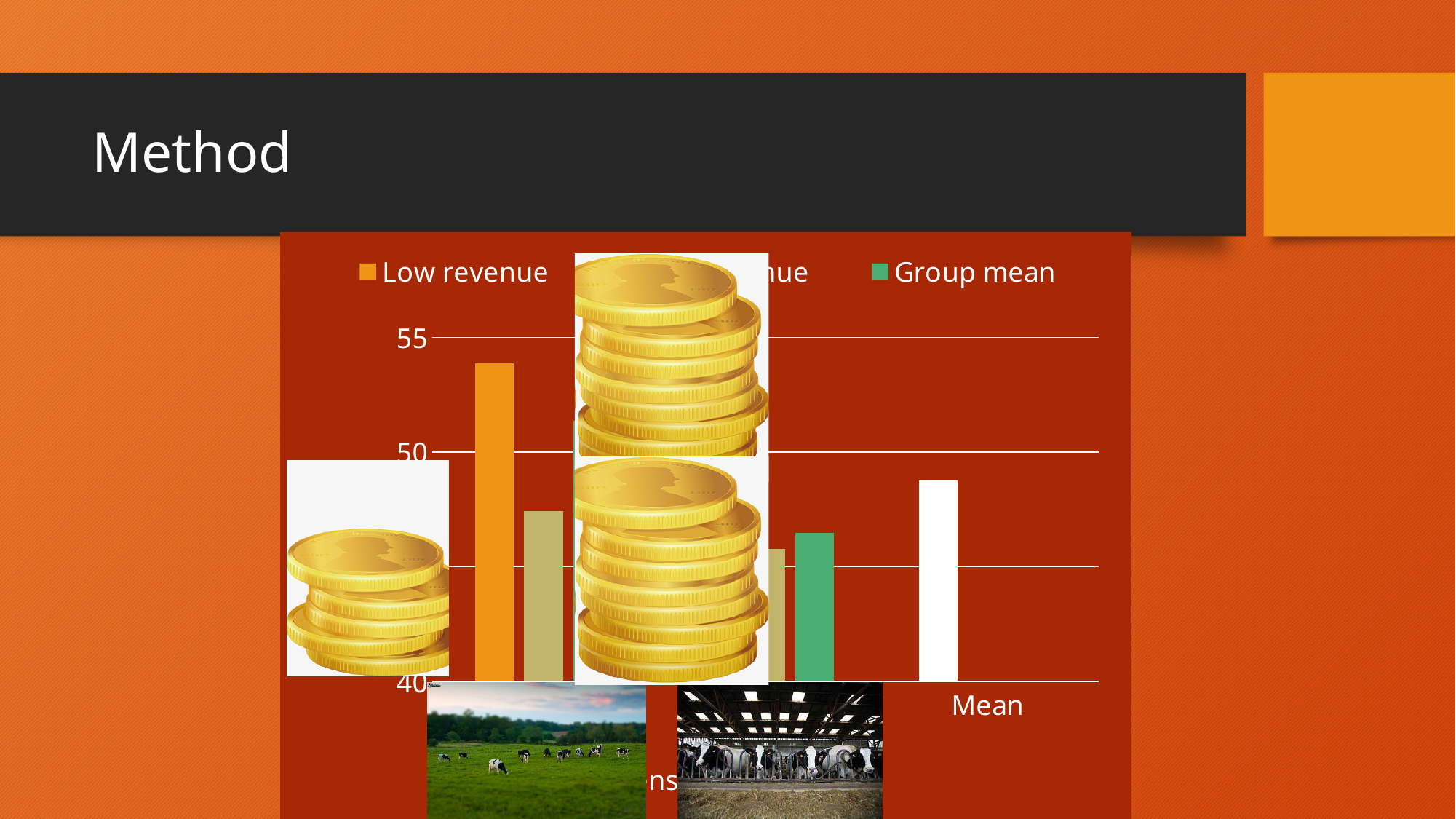
Is the value of the orange Low revenue bar greater or less than 55? less What is the highest value labelled on the vertical axis? 55 Is the value of the white bar for the Mean category greater or less than 50? less What colour represents the Low revenue series in the legend? orange Is the value of the orange Low revenue bar greater or less than 50? greater What kind of chart is shown on the slide? bar chart Which bar on the chart is the tallest? the orange Low revenue bar Which is taller: the orange Low revenue bar or the white bar for Mean? the orange Low revenue bar